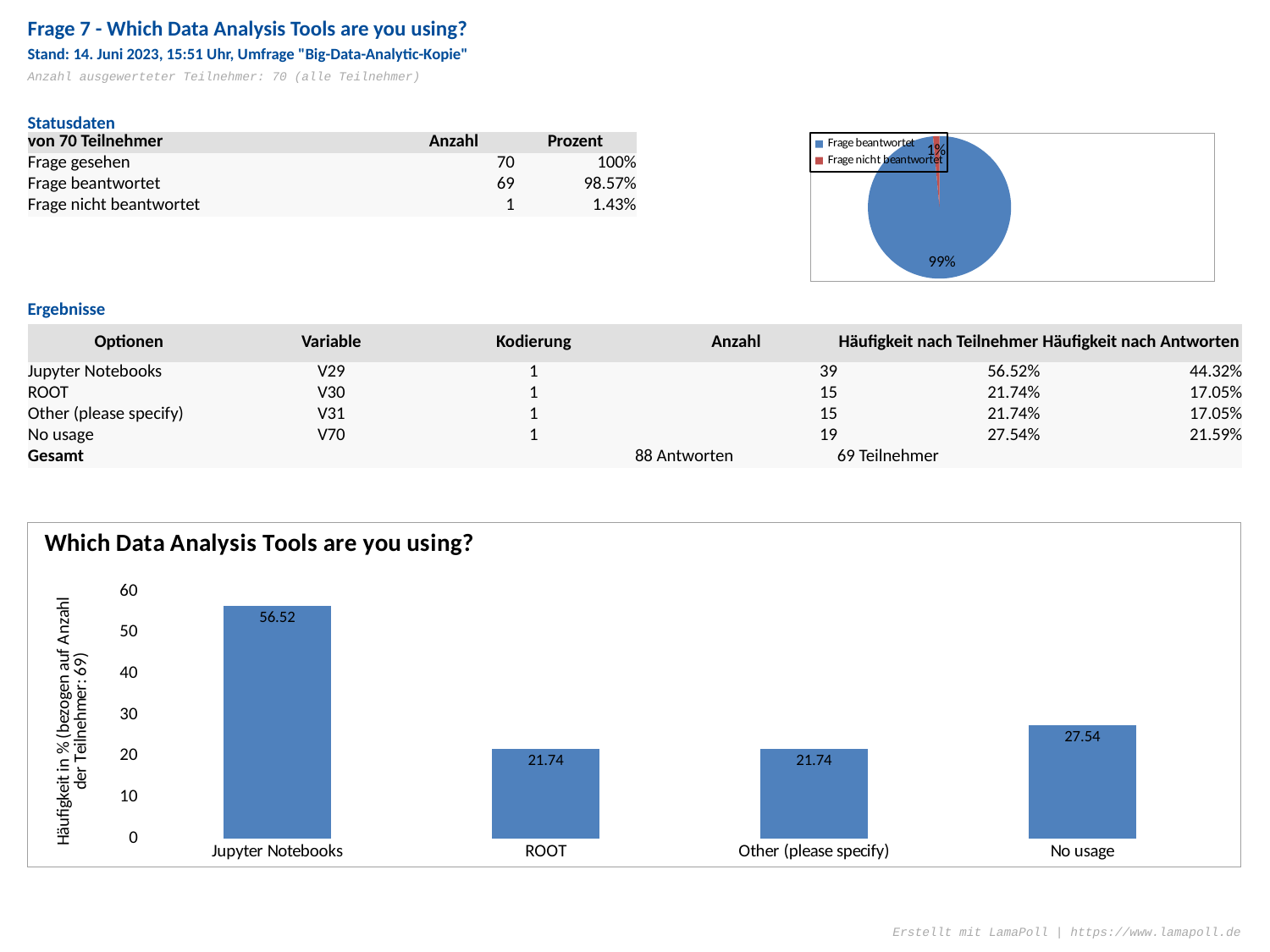
How many categories are shown in the bar chart 'Which Data Analysis Tools are you using?'? 4 In the bar chart 'Which Data Analysis Tools are you using?', what is the value for No usage? 27.54 In the bar chart 'Which Data Analysis Tools are you using?', what is the value for Jupyter Notebooks? 56.52 In the pie chart at the top right of the slide, what share does 'Frage nicht beantwortet' have? 1% In the bar chart 'Which Data Analysis Tools are you using?', what is the difference between the values for Jupyter Notebooks and No usage? 28.98 In the bar chart 'Which Data Analysis Tools are you using?', which is larger, the value for No usage or the value for ROOT? No usage In the bar chart 'Which Data Analysis Tools are you using?', what is the value for ROOT? 21.74 How many entries does the legend of the pie chart at the top right of the slide list? 2 In the bar chart 'Which Data Analysis Tools are you using?', is the value for Jupyter Notebooks greater or less than 50? greater In the bar chart 'Which Data Analysis Tools are you using?', which category has the highest value? Jupyter Notebooks In the pie chart at the top right of the slide, what share does 'Frage beantwortet' have? 99% What kind of chart is 'Which Data Analysis Tools are you using?'? bar chart